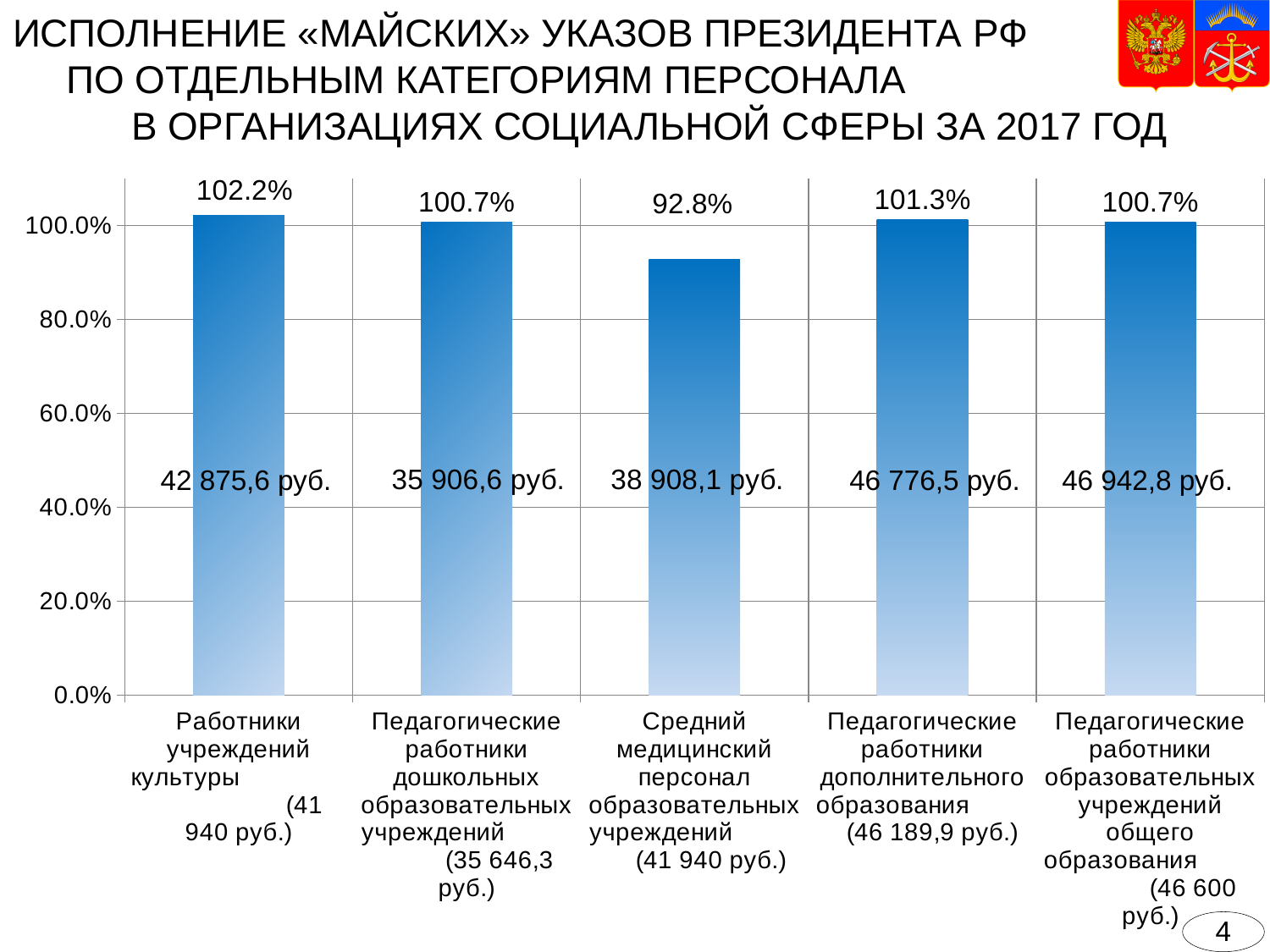
Which has a higher percentage: Педагогические работники дополнительного образования or Педагогические работники дошкольных образовательных учреждений? Педагогические работники дополнительного образования Which category has the lowest percentage? Средний медицинский персонал образовательных учреждений What kind of chart is shown on the slide? bar chart What ruble amount is printed on the bar for Педагогические работники образовательных учреждений общего образования? 46 942,8 руб. Is the value for Средний медицинский персонал образовательных учреждений greater or less than 100.0%? less What percentage is shown for Средний медицинский персонал образовательных учреждений? 92.8% What is the difference in percentage points between Работники учреждений культуры and Средний медицинский персонал образовательных учреждений? 9.4 What percentage is shown for Педагогические работники дополнительного образования? 101.3% How many categories are shown in the chart? 5 What ruble amount is printed on the bar for Педагогические работники дошкольных образовательных учреждений? 35 906,6 руб. What percentage is shown for Работники учреждений культуры? 102.2% Which category has the highest percentage? Работники учреждений культуры